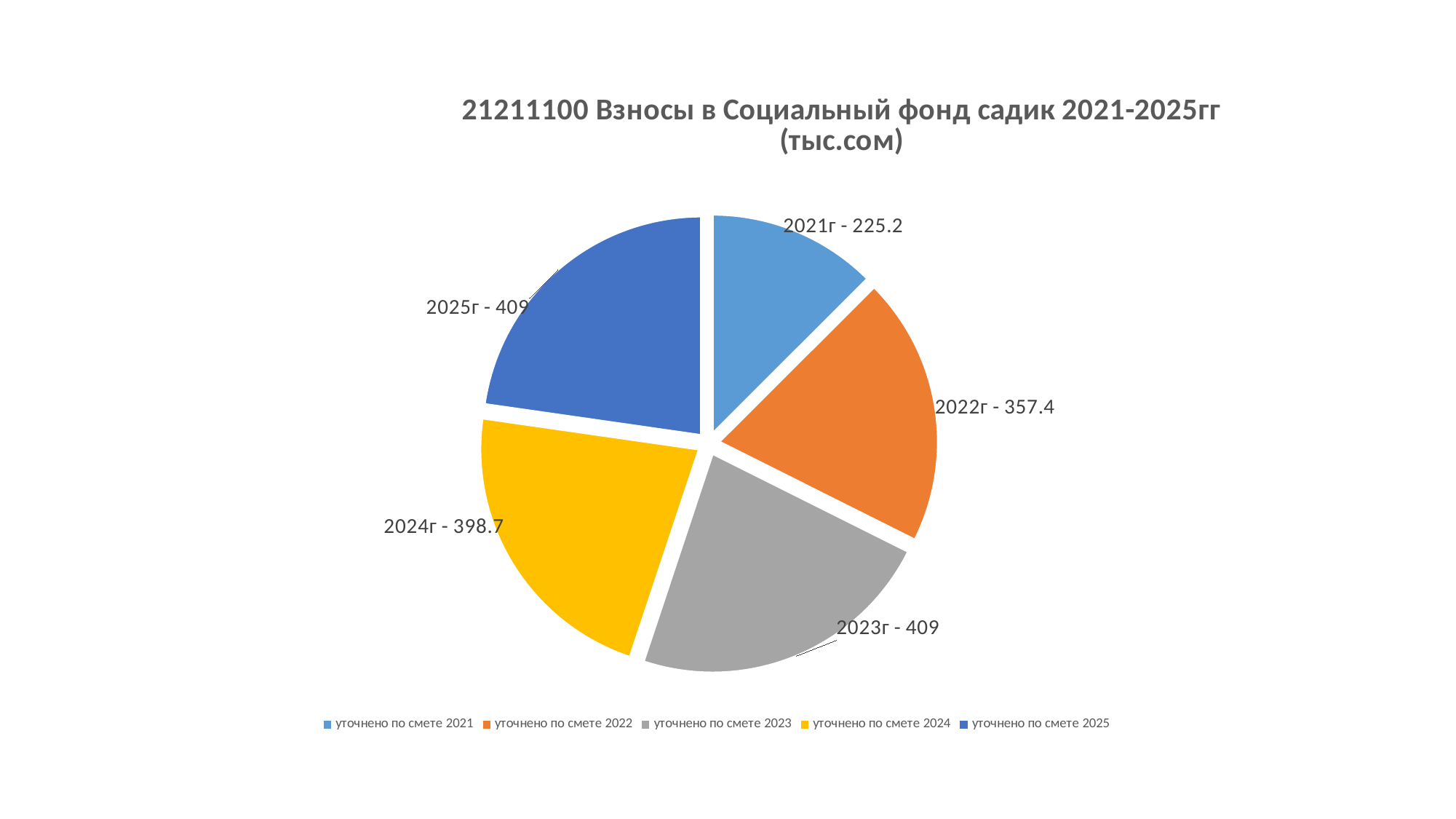
Which two years share the largest value in the pie chart? 2023 and 2025 What is the value for 2024 in the pie chart? 398.7 What unit is given in the chart title? тыс.сом Which year has the smallest slice in the pie chart? 2021 What kind of chart is shown on the slide? pie chart What is the difference between the values for 2023 and 2024? 10.3 What is the value for 2025 in the pie chart? 409 Which is larger, the value for 2024 or the value for 2022? 2024 What is the difference between the values for 2022 and 2021? 132.2 How many slices does the pie chart have? 5 What is the value for 2022 in the pie chart? 357.4 What is the value for 2021 in the pie chart? 225.2